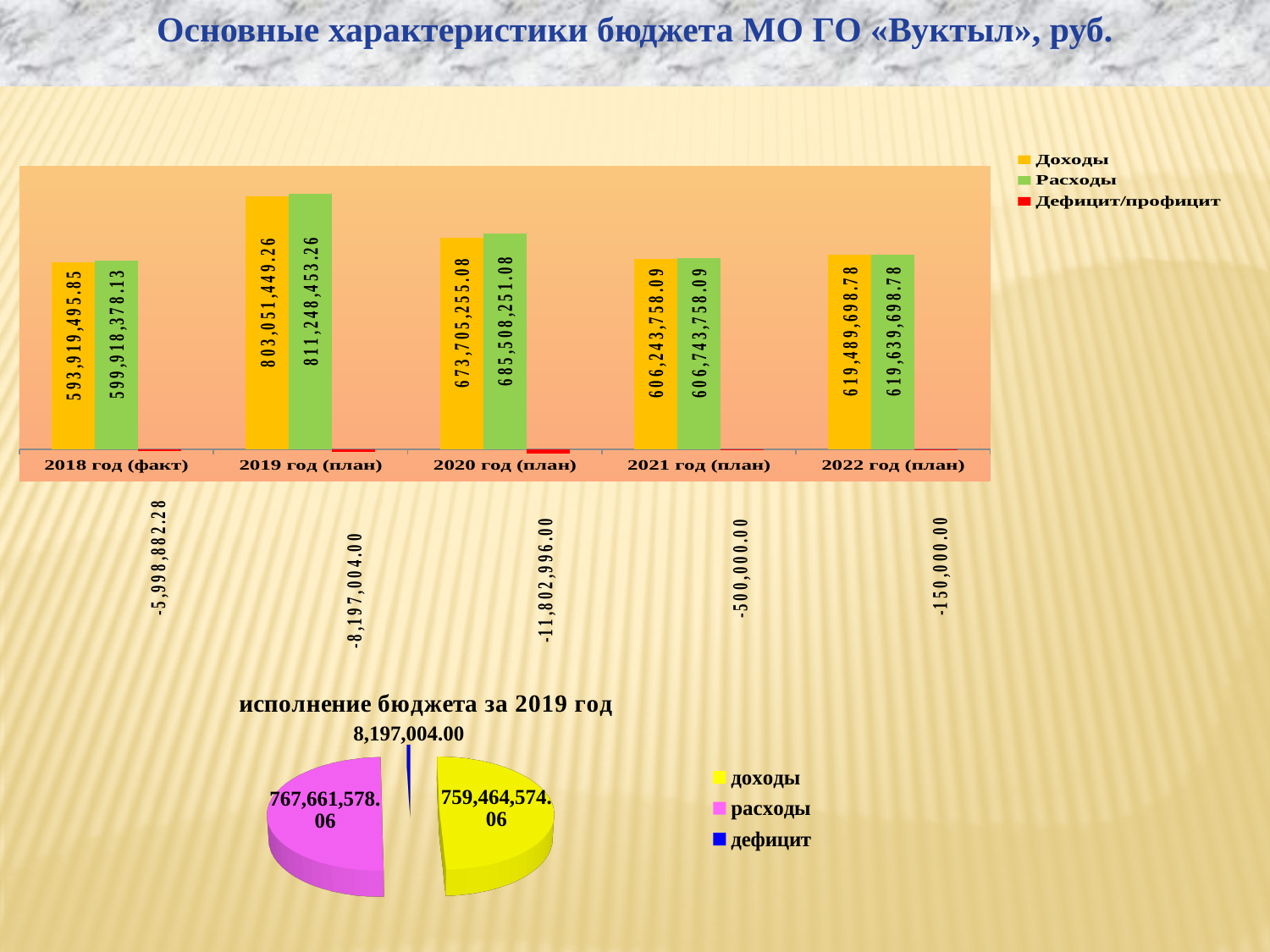
In the top bar chart, which year has the highest Доходы? 2019 год (план) In the top bar chart, what is the value of Доходы for 2018 год (факт)? 593,919,495.85 How many series does the legend of the top bar chart list? 3 In the top bar chart, which year has the lowest Расходы? 2018 год (факт) In the pie chart 'исполнение бюджета за 2019 год', what is the value of расходы? 767,661,578.06 In the top bar chart, what is the value of Дефицит/профицит for 2022 год (план)? -150,000.00 What kind of chart is the chart titled 'исполнение бюджета за 2019 год'? pie chart In the top bar chart, what is the value of Расходы for 2020 год (план)? 685,508,251.08 In the top bar chart, which is larger for 2021 год (план): Доходы or Расходы? Расходы In the top bar chart, what is the difference between Расходы and Доходы for 2019 год (план)? 8,197,004.00 In the pie chart 'исполнение бюджета за 2019 год', which slice is the smallest? дефицит How many year categories are shown on the x axis of the top bar chart? 5